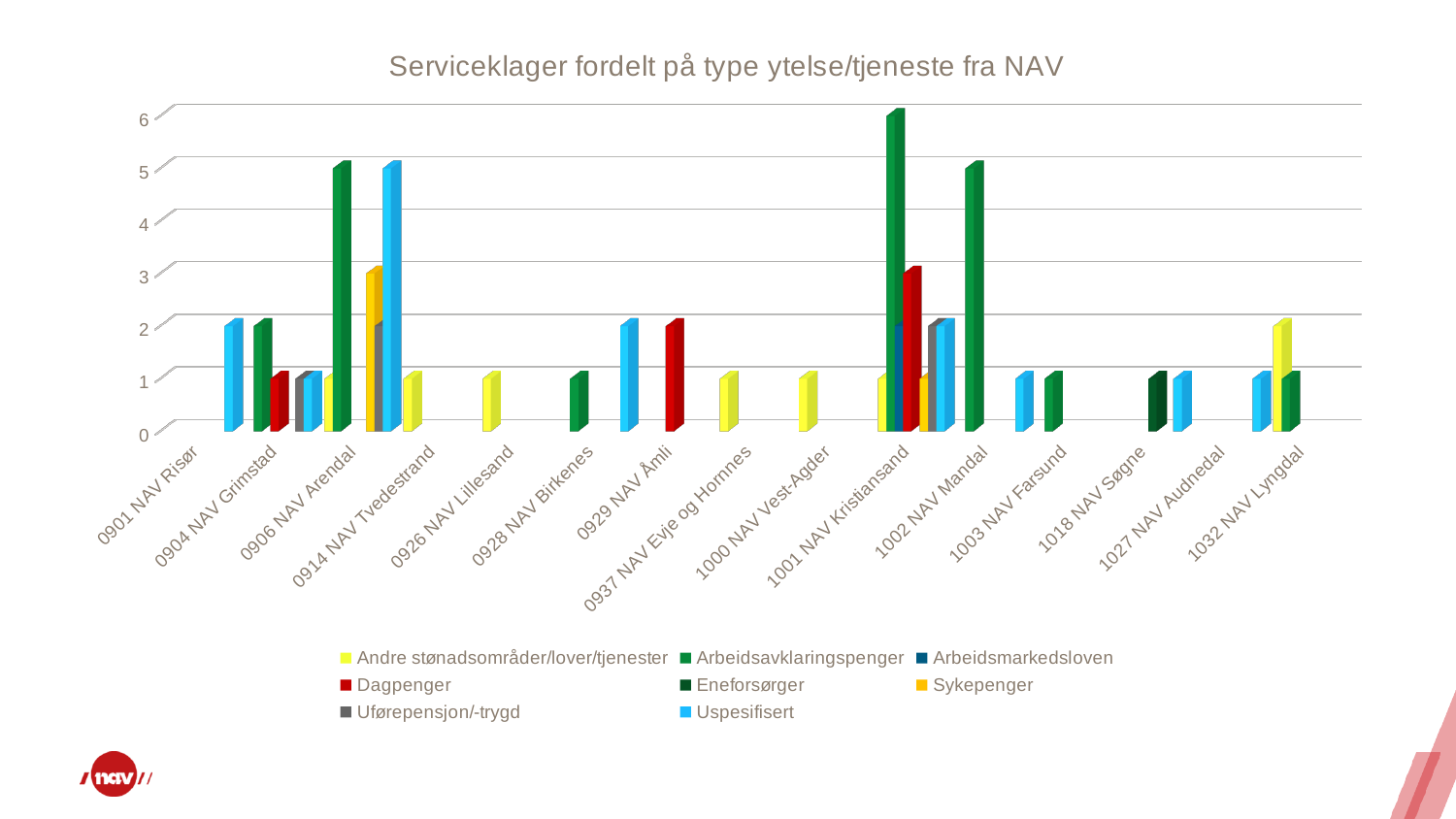
How many NAV offices (categories) are shown on the x axis? 15 What is the value of Dagpenger for 0929 NAV Åmli? 2 What is the value of Uspesifisert for 0928 NAV Birkenes? 2 Which has the larger Arbeidsavklaringspenger value, 1001 NAV Kristiansand or 1002 NAV Mandal? 1001 NAV Kristiansand What is the value of Arbeidsavklaringspenger for 1001 NAV Kristiansand? 6 What is the value of Sykepenger for 0906 NAV Arendal? 3 Which NAV office has the tallest bar in the chart? 1001 NAV Kristiansand How many series does the legend list? 8 What kind of chart is shown on the slide? Bar chart Is the Arbeidsavklaringspenger value for 1001 NAV Kristiansand greater or less than 5? greater What is the difference between the Arbeidsavklaringspenger values for 1001 NAV Kristiansand and 1002 NAV Mandal? 1 What is the title of the chart? Serviceklager fordelt på type ytelse/tjeneste fra NAV